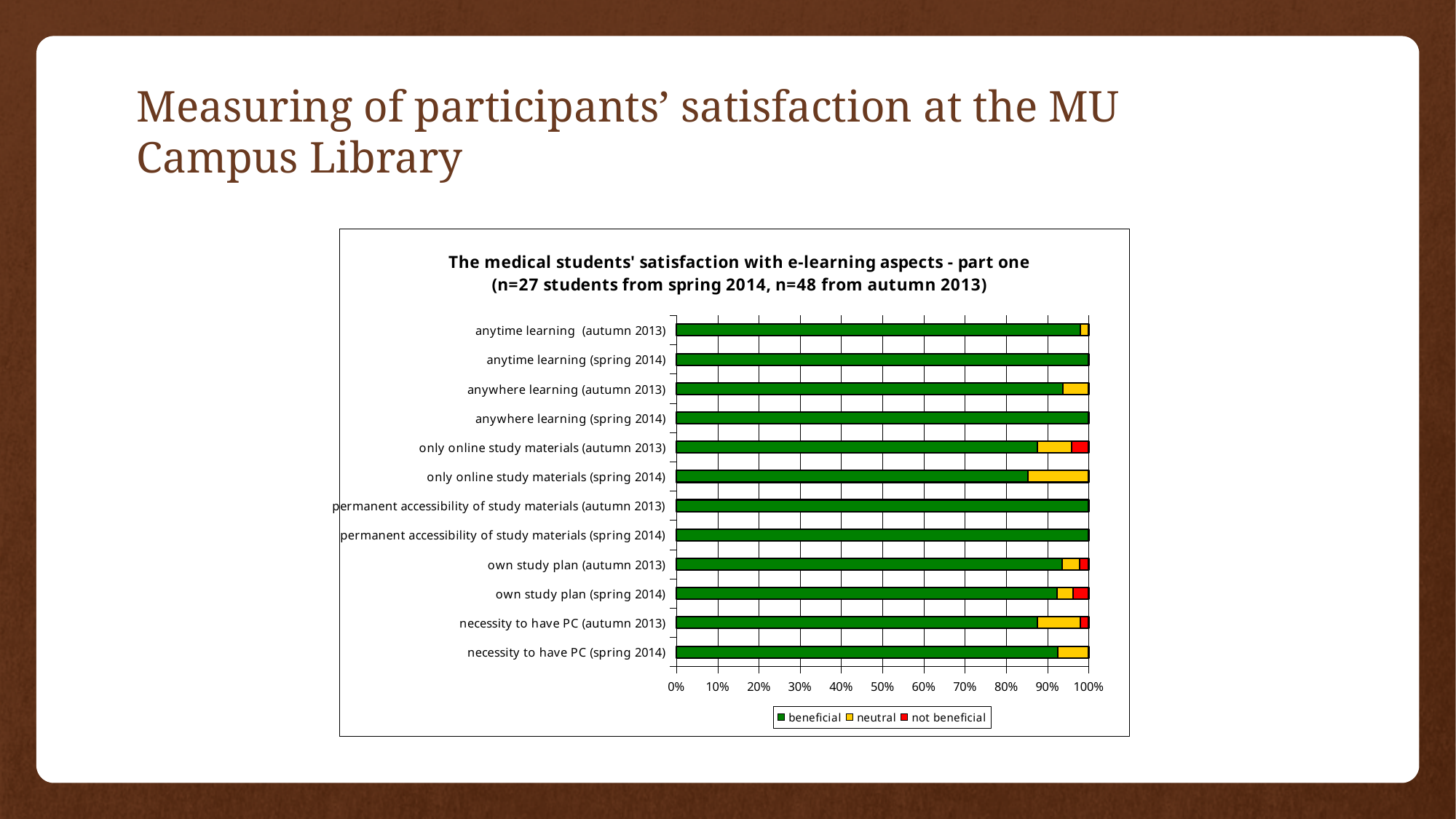
Which has the larger beneficial share: anytime learning (spring 2014) or only online study materials (spring 2014)? anytime learning (spring 2014) Which colour represents the 'not beneficial' series in the legend? red Is the beneficial share for own study plan (autumn 2013) greater or less than 90%? greater How many categories (bars) does the chart show? 12 What is the title of the chart? The medical students' satisfaction with e-learning aspects - part one (n=27 students from spring 2014, n=48 from autumn 2013) Is the beneficial share for necessity to have PC (autumn 2013) greater or less than 90%? less How many series does the legend list? 3 Is the beneficial share for only online study materials (spring 2014) greater or less than 90%? less Which has the larger beneficial share: anywhere learning (spring 2014) or anywhere learning (autumn 2013)? anywhere learning (spring 2014) What kind of chart is shown on the slide? bar chart What is the beneficial share for anytime learning (spring 2014)? 100%